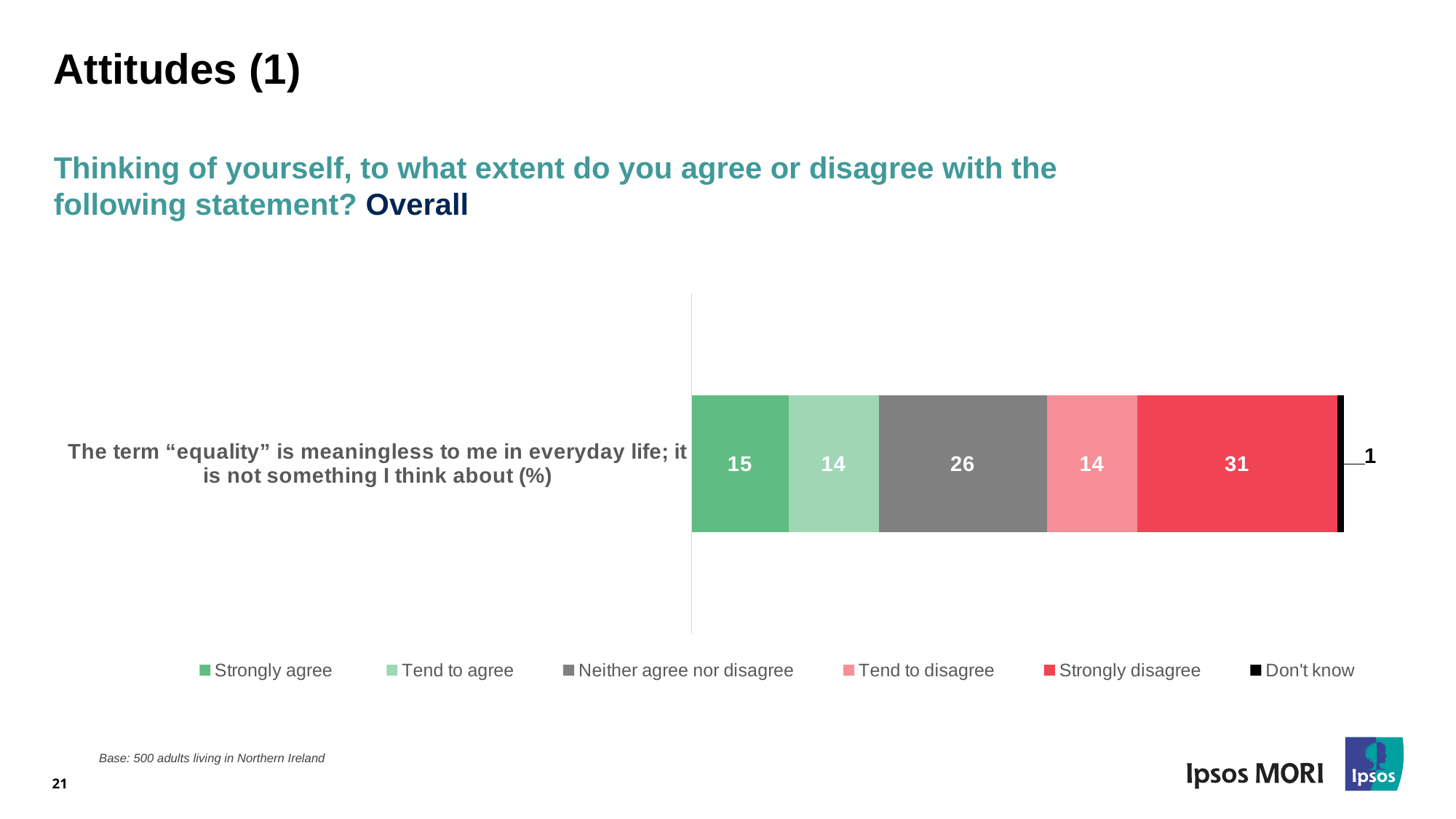
Which response category has the lowest value? Don't know What percentage of respondents strongly agree with the statement? 15 How many series does the legend list? 6 What percentage of respondents strongly disagree with the statement? 31 Which response category has the highest value? Strongly disagree What is the total of all segments in the stacked bar? 101 What percentage of respondents neither agree nor disagree with the statement? 26 What percentage of respondents answered 'Don't know'? 1 What kind of chart is shown on the slide? Stacked bar chart Which is larger, the 'Neither agree nor disagree' value or the 'Tend to disagree' value? Neither agree nor disagree What is the difference between the 'Strongly disagree' and 'Strongly agree' values? 16 What colour is the 'Don't know' segment in the legend? Black